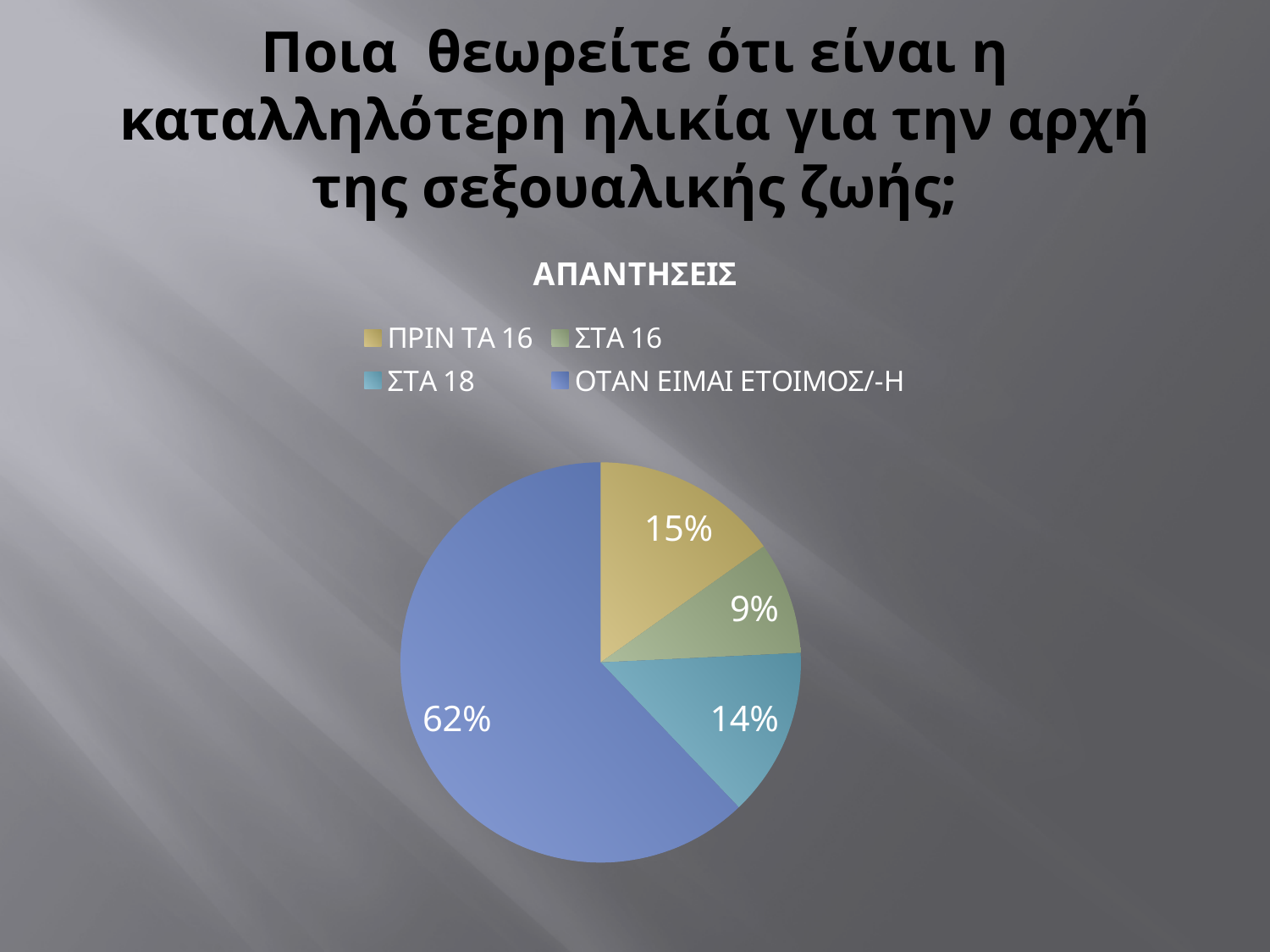
How many entries does the legend list? 4 Which is larger, the share for ΠΡΙΝ ΤΑ 16 or the share for ΣΤΑ 18? ΠΡΙΝ ΤΑ 16 Which category has the largest share of the pie? ΟΤΑΝ ΕΙΜΑΙ ΕΤΟΙΜΟΣ/-Η Which category has the smallest share of the pie? ΣΤΑ 16 What percentage is shown for ΣΤΑ 18? 14% What kind of chart is shown on the slide? pie chart What is the difference in percentage points between ΟΤΑΝ ΕΙΜΑΙ ΕΤΟΙΜΟΣ/-Η and ΠΡΙΝ ΤΑ 16? 47 What is the title of the chart? ΑΠΑΝΤΗΣΕΙΣ What percentage is shown for ΣΤΑ 16? 9% How many slices does the pie chart have? 4 What percentage is shown for ΠΡΙΝ ΤΑ 16? 15% What percentage is shown for ΟΤΑΝ ΕΙΜΑΙ ΕΤΟΙΜΟΣ/-Η? 62%